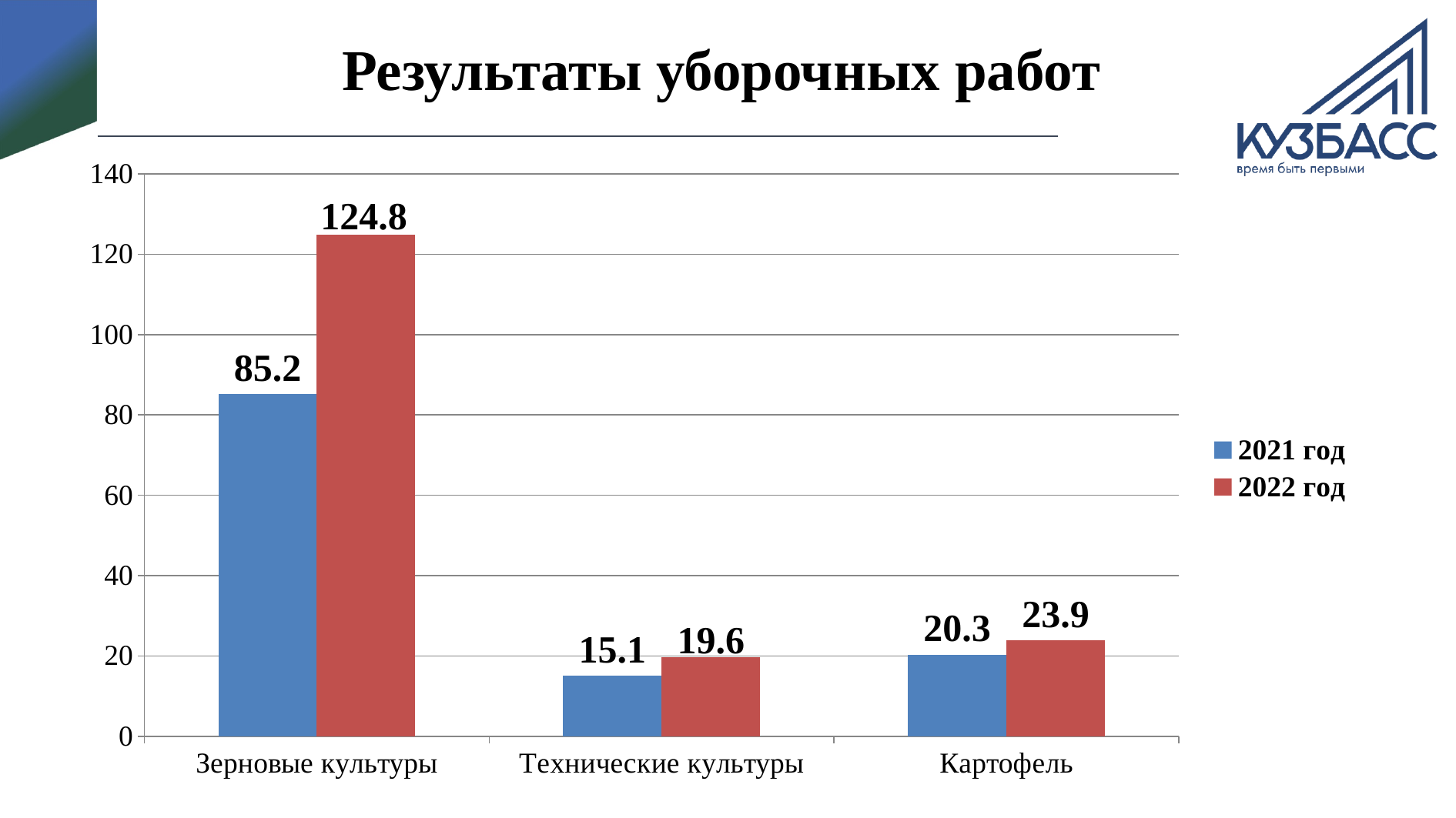
What is the value for Картофель in 2022 год? 23.9 Which category has the lowest value in 2022 год? Технические культуры How many series does the legend list? 2 Which category has the highest value in 2021 год? Зерновые культуры How many categories are shown on the x axis? 3 What is the difference between the 2022 год and 2021 год values for Зерновые культуры? 39.6 Which is larger: the 2021 год value for Картофель or the 2022 год value for Технические культуры? 2021 год value for Картофель What is the difference between the 2022 год and 2021 год values for Картофель? 3.6 What kind of chart is shown on the slide? bar chart What is the value for Технические культуры in 2021 год? 15.1 Is the value for Зерновые культуры in 2021 год greater or less than 100? less What is the value for Зерновые культуры in 2022 год? 124.8